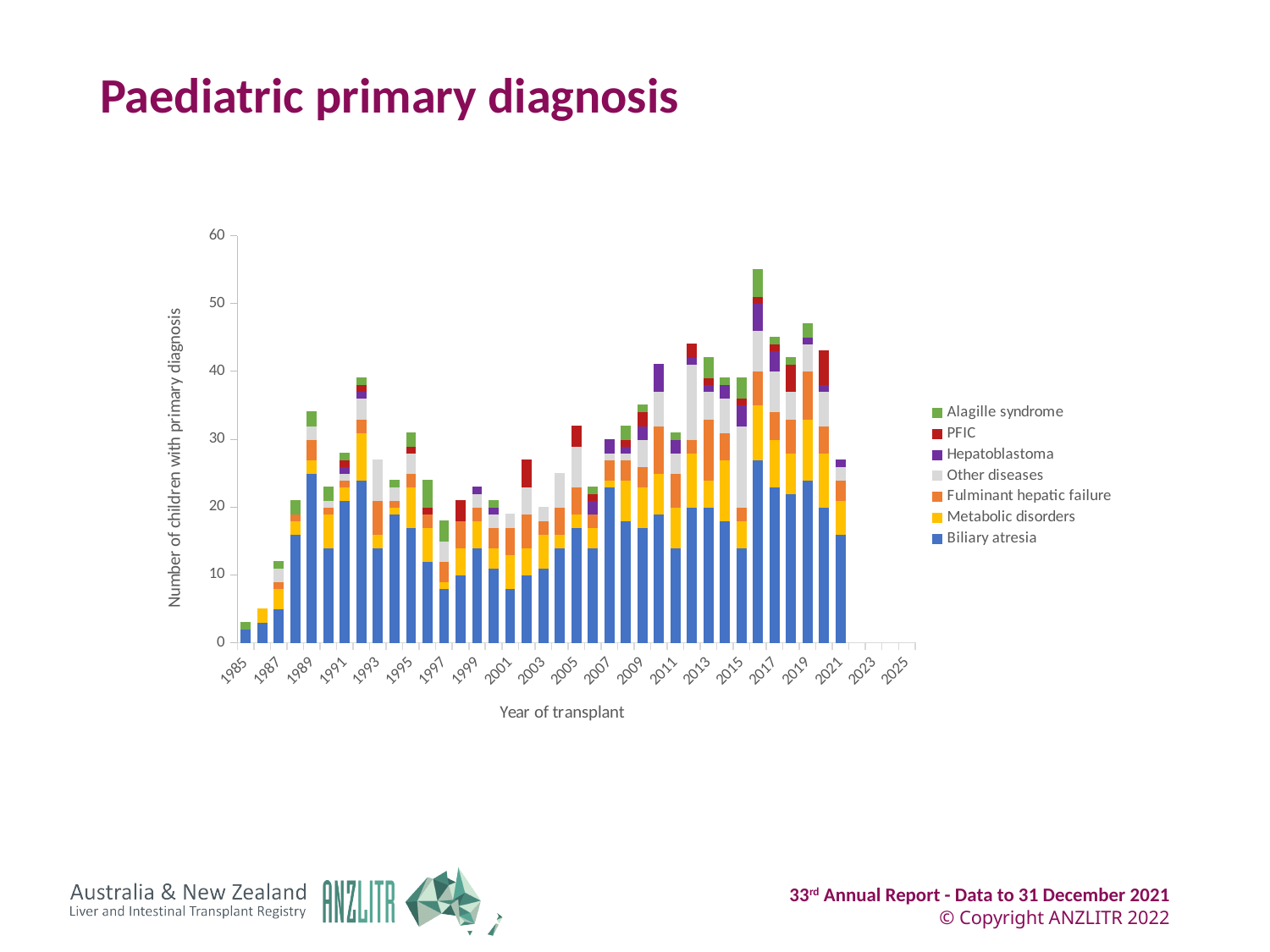
Is the total number of children for 2021 greater or less than 30? less Which year of transplant has the shortest stacked bar? 1985 Is the total number of children for 2016 greater or less than 50? greater Is the total number of children for 1985 greater or less than 10? less Which series is shown at the bottom of each stacked bar? Biliary atresia Do the total numbers of children generally rise or fall from 2001 to 2016? rise What is the title of the y axis? Number of children with primary diagnosis Which year of transplant has the tallest stacked bar? 2016 Which year has a taller stacked bar, 1989 or 1990? 1989 How many series does the legend list? 7 What kind of chart is shown on the slide? Stacked bar chart